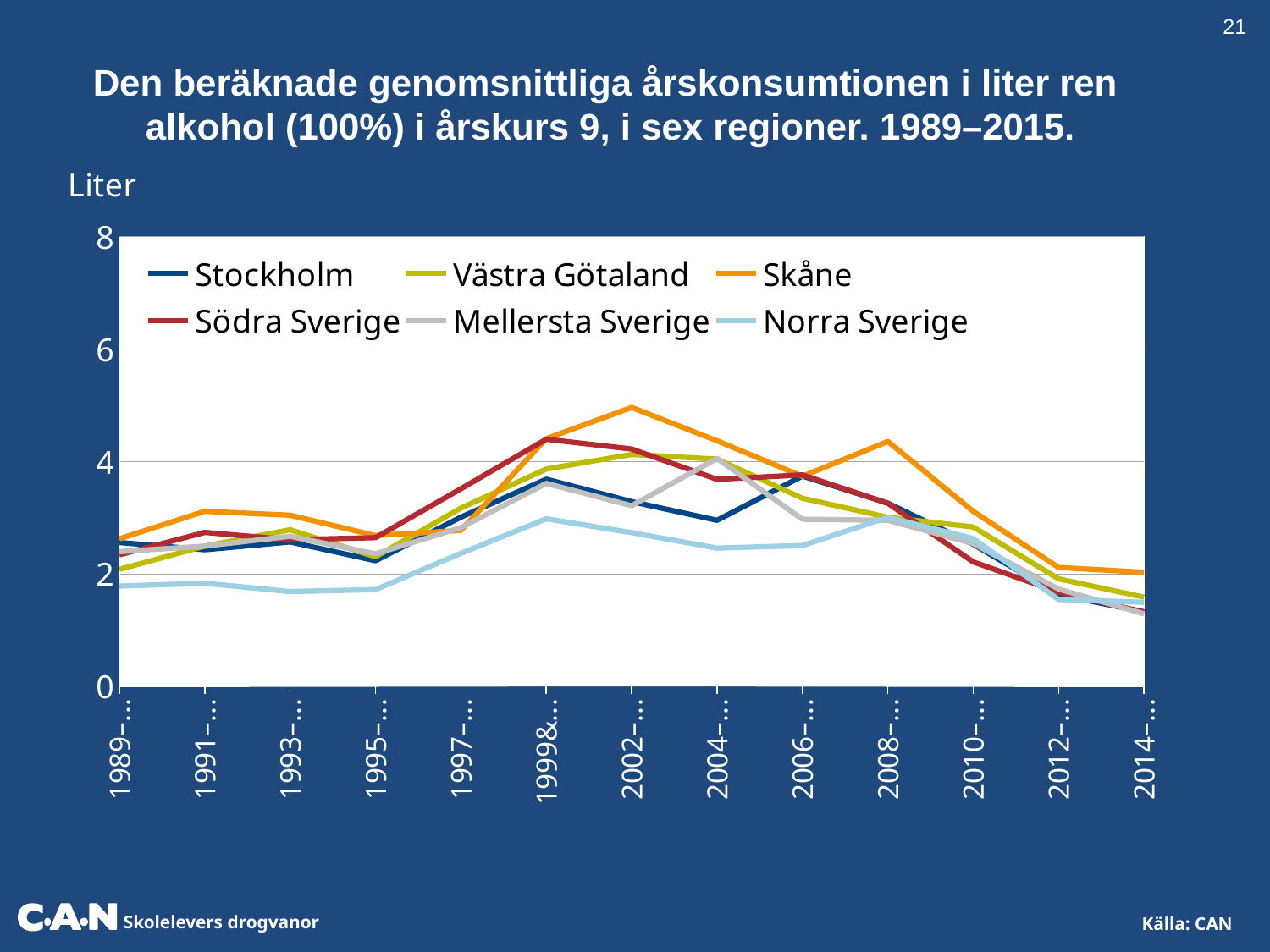
What kind of chart is shown on the slide? line chart Does the Norra Sverige line rise or fall from the 1995 point to the 1999 point? rise Which region has the highest value at the 2008 point? Skåne Which region has the lowest value at the 1997 point? Norra Sverige Is the value for Västra Götaland at the 2014 point greater or less than 2? less Does the Skåne line rise or fall from the 2008 point to the 2014 point? fall Which region has the lowest value at the 1989 point? Norra Sverige Is the value for Skåne at the 2002 point greater or less than 4? greater Which region has the highest value at the 2002 point? Skåne What unit is shown above the y axis of the chart? Liter How many series does the legend list? 6 Is the value for Norra Sverige at the 1989 point greater or less than 2? less